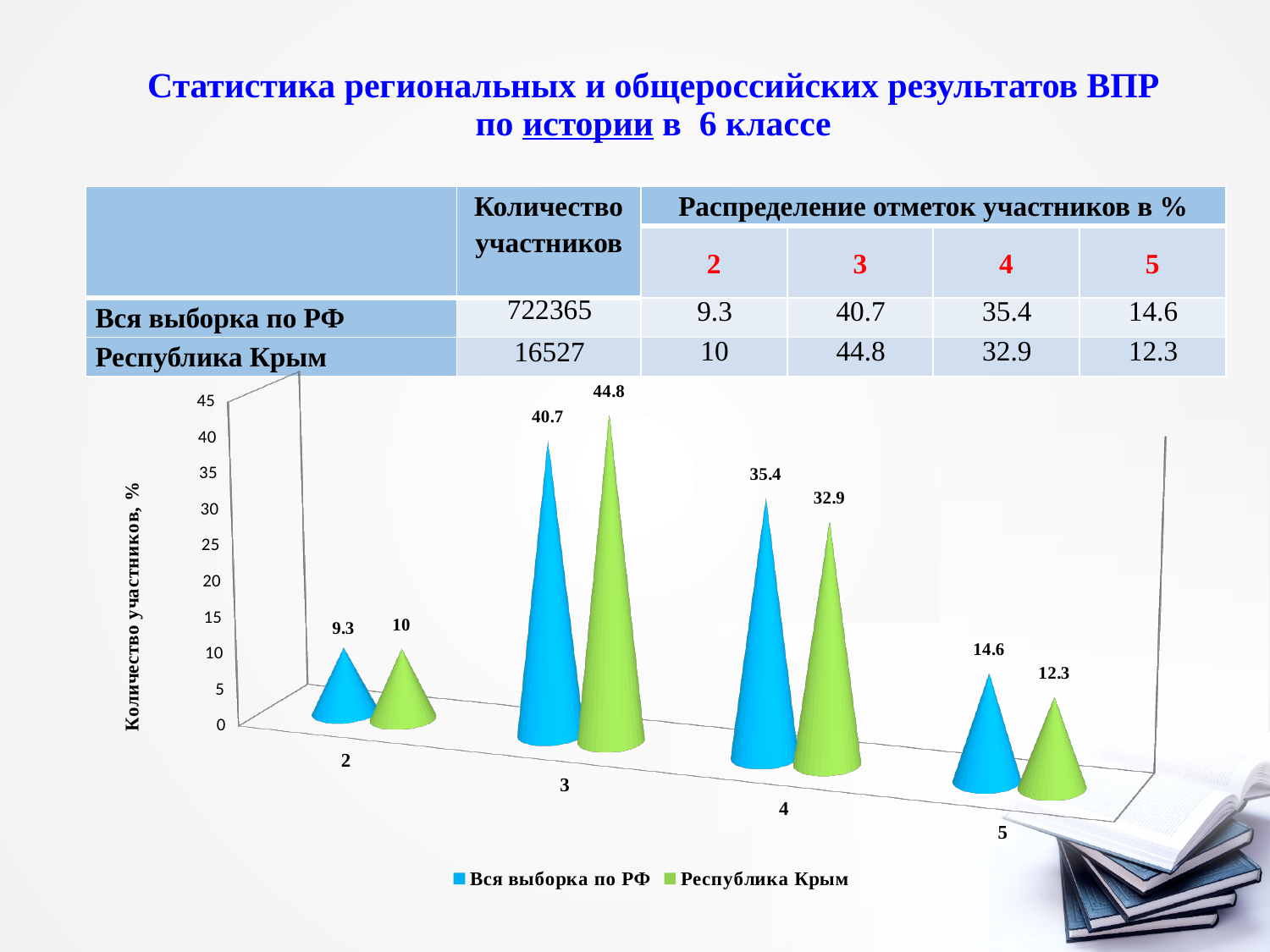
What is the difference between "Республика Крым" and "Вся выборка по РФ" at grade 3? 4.1 What is the label of the vertical axis? Количество участников, % How many grade categories are shown on the x axis? 4 How many series does the legend list? 2 What is the value for "Республика Крым" at grade 5? 12.3 What is the value for "Республика Крым" at grade 3? 44.8 What is the value for "Вся выборка по РФ" at grade 4? 35.4 What kind of chart is shown on the slide? bar chart What is the value for "Вся выборка по РФ" at grade 2? 9.3 Which grade has the lowest value for "Республика Крым"? 2 At grade 4, which series has the larger value: "Вся выборка по РФ" or "Республика Крым"? Вся выборка по РФ Which grade has the highest value for "Вся выборка по РФ"? 3